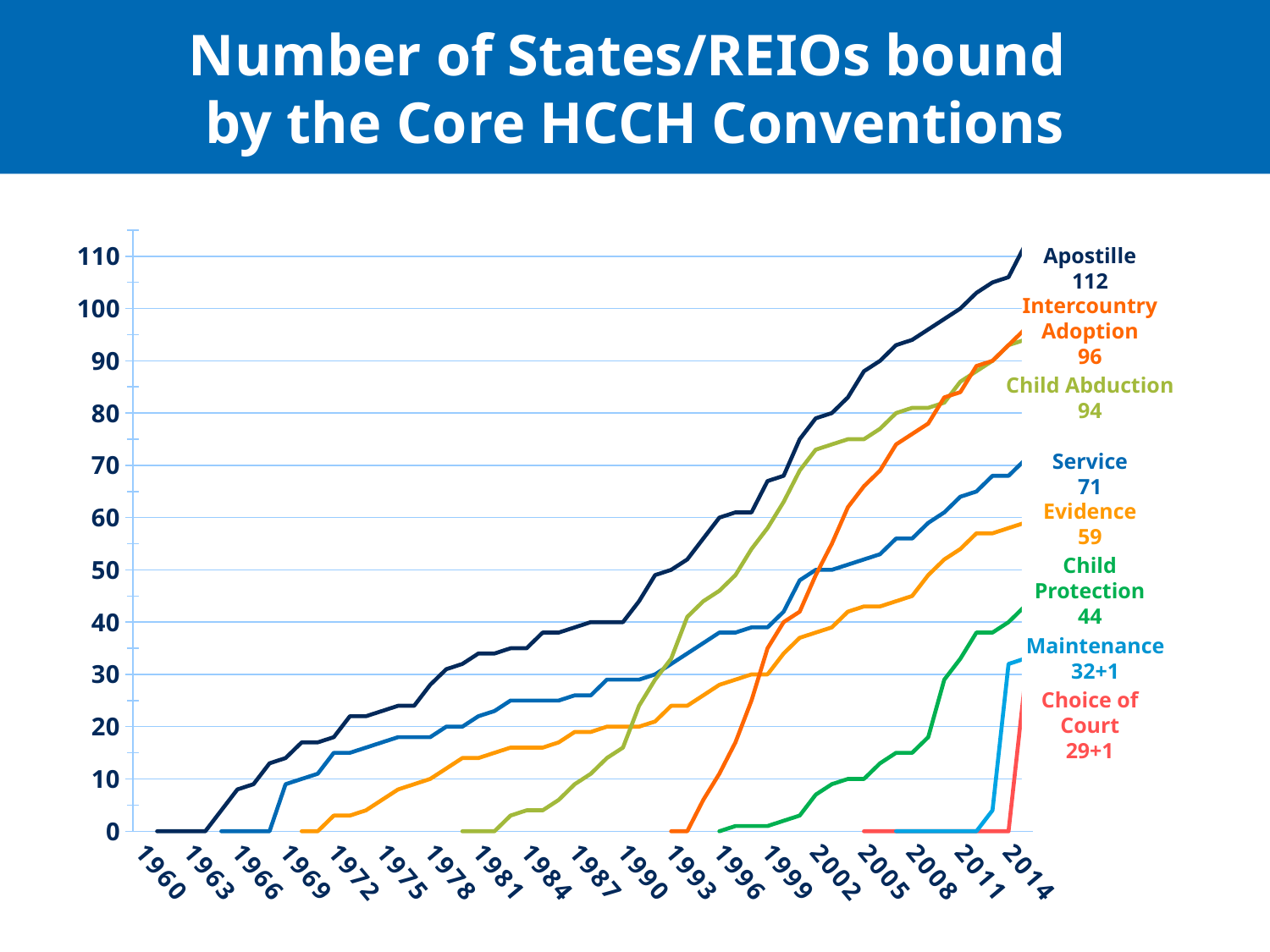
How many conventions (series) are plotted on the chart? 8 What is the difference between the final values for Apostille and Intercountry Adoption? 16 What is the final value shown for the Maintenance Convention? 32+1 Which has a higher final value, Service or Evidence? Service What is the final value shown for the Intercountry Adoption Convention? 96 Which convention has the lowest final value shown on the chart? Choice of Court What is the final value shown for the Choice of Court Convention? 29+1 Is the value for Child Abduction in 2005 greater or less than 70? greater What type of chart is shown on the slide? line chart What is the number of States/REIOs bound by the Apostille Convention shown at the end of the line? 112 Do the lines generally rise or fall from 1960 to 2014? rise Which convention has the highest number of States/REIOs bound at the end of the chart? Apostille